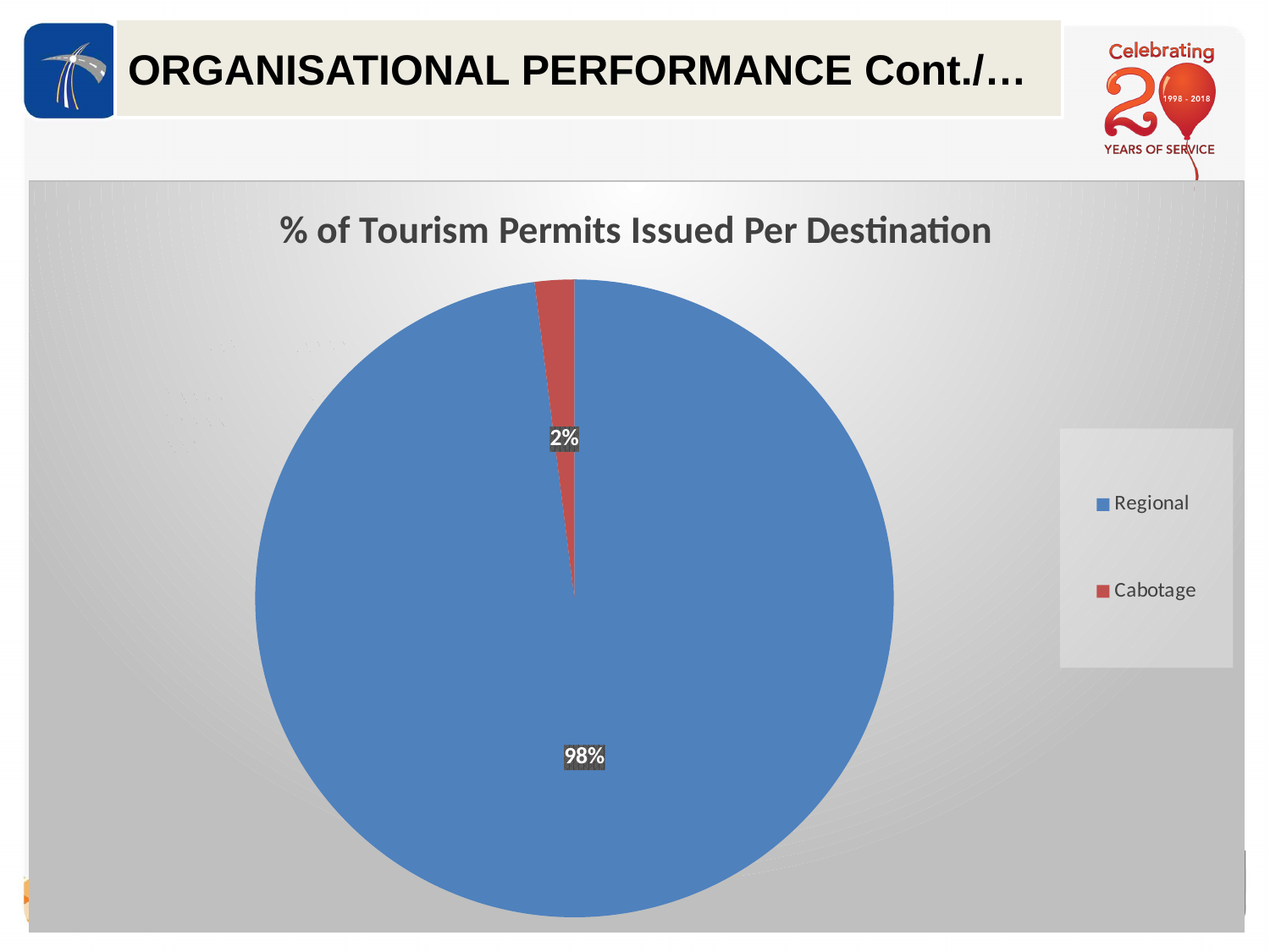
What is the difference in percentage points between the Regional and Cabotage shares? 96 What colour represents Cabotage in the pie chart? red Which destination category has the smallest share of tourism permits? Cabotage What type of chart is shown on the slide? pie chart What is the title of the chart? % of Tourism Permits Issued Per Destination What percentage of tourism permits were issued for Cabotage? 2% Which destination category has the largest share of tourism permits? Regional What share of the pie does the Regional slice represent? 98% Which is larger, the share for Regional or the share for Cabotage? Regional What percentage of tourism permits were issued for Regional destinations? 98% How many categories does the legend list? 2